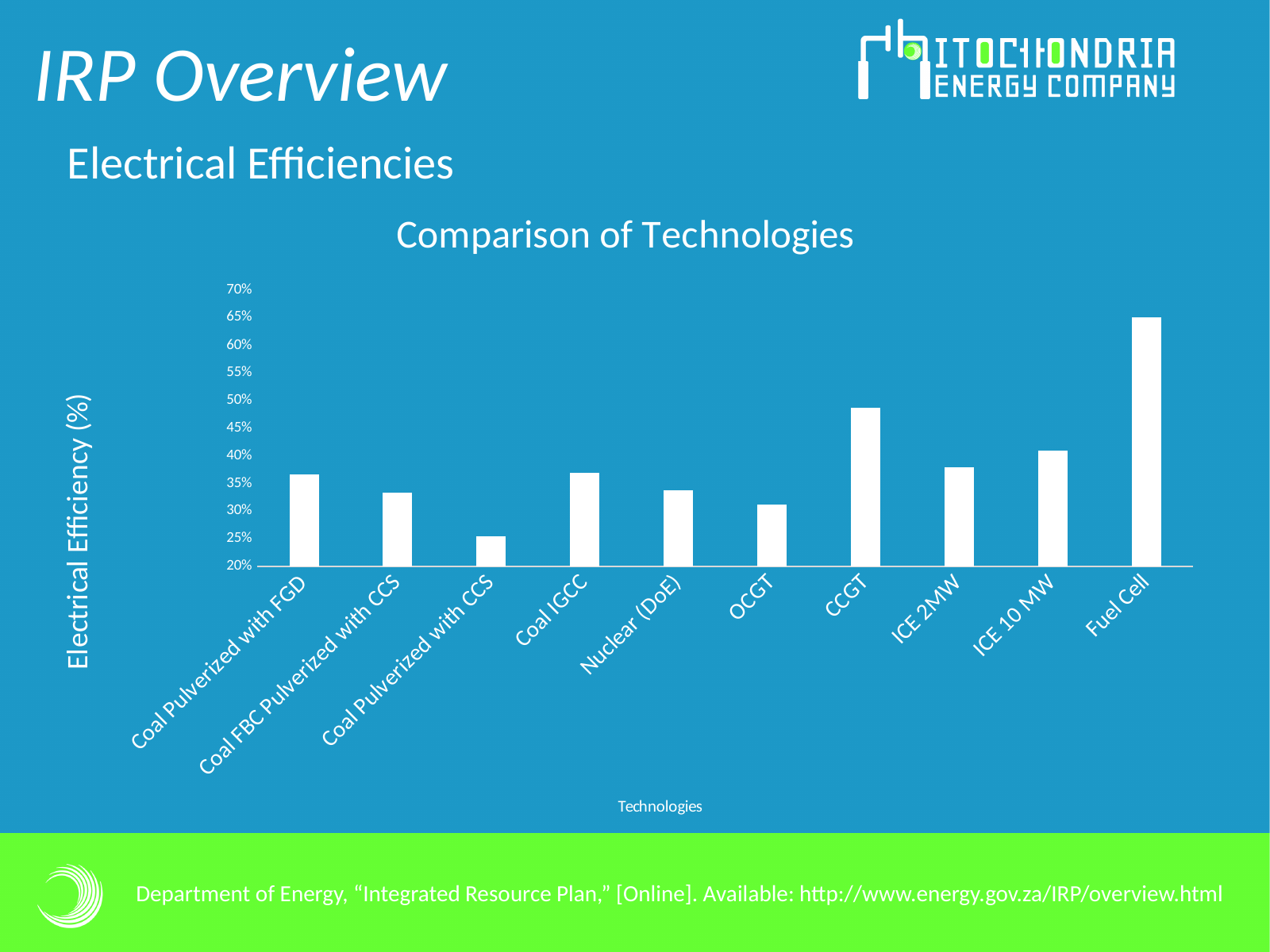
Which technology has the highest electrical efficiency? Fuel Cell Is the value for ICE 10 MW greater or less than 35%? greater Which has a higher electrical efficiency, Fuel Cell or CCGT? Fuel Cell Is the value for CCGT greater or less than 45%? greater Which has a higher electrical efficiency, CCGT or OCGT? CCGT Is the value for Coal Pulverized with CCS greater or less than 30%? less Which technology has the lowest electrical efficiency? Coal Pulverized with CCS How many technologies are plotted on the chart? 10 What is the label of the vertical axis? Electrical Efficiency (%) What kind of chart is shown on the slide? bar chart What is the title of the chart? Comparison of Technologies